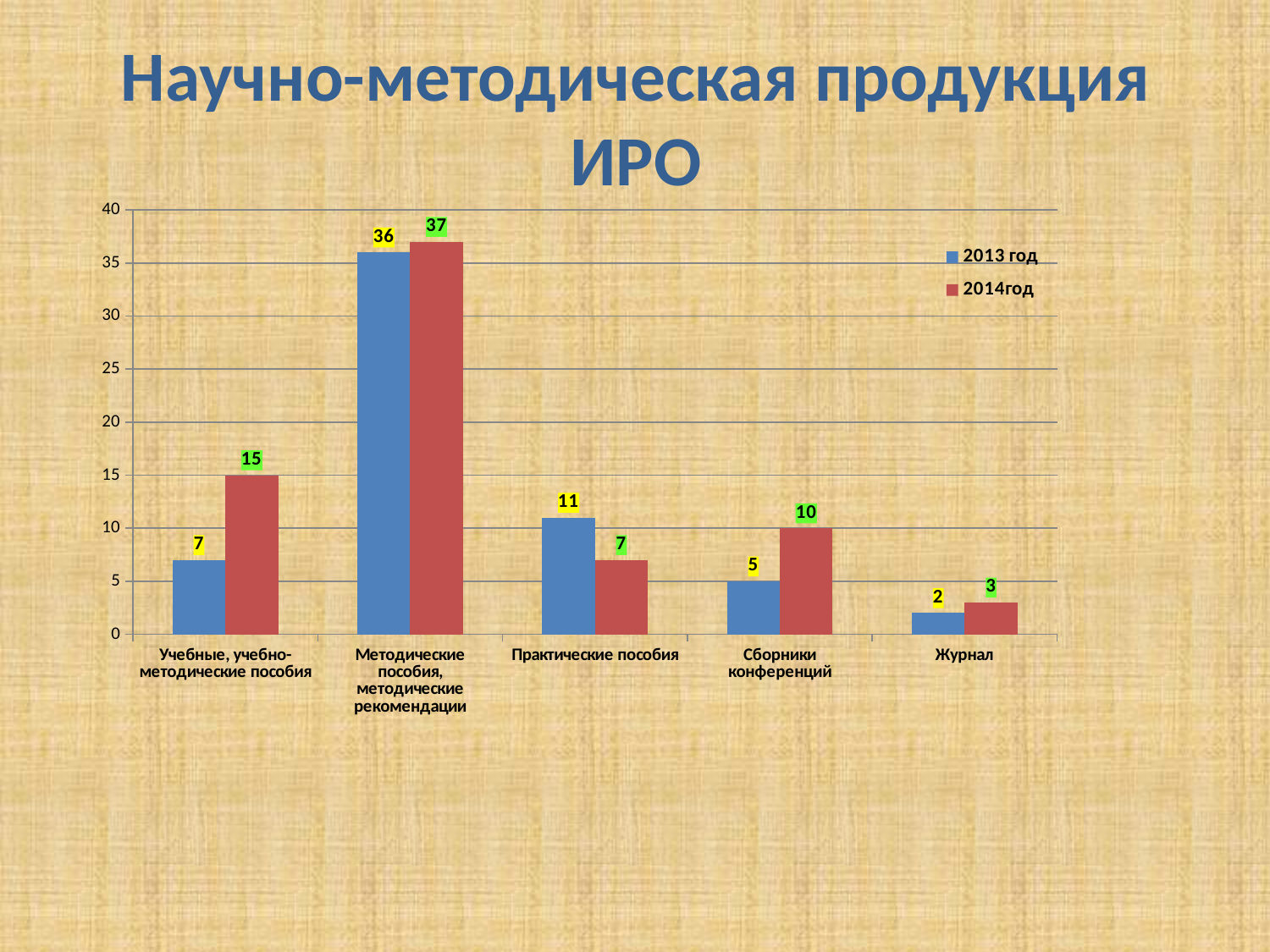
Which category has the highest value in 2014год? Методические пособия, методические рекомендации Which category has the lowest value in 2013 год? Журнал Which is larger for Практические пособия: the 2013 год value or the 2014год value? 2013 год What is the title of the slide? Научно-методическая продукция ИРО Is the value for Методические пособия, методические рекомендации in 2014год greater or less than 35? greater How many series does the legend list? 2 How many categories are shown on the x axis? 5 What is the value for Методические пособия, методические рекомендации in 2013 год? 36 What is the value for Журнал in 2013 год? 2 What is the value for Сборники конференций in 2014год? 10 What is the difference between the 2014год and 2013 год values for Учебные, учебно-методические пособия? 8 What kind of chart is shown on the slide? bar chart